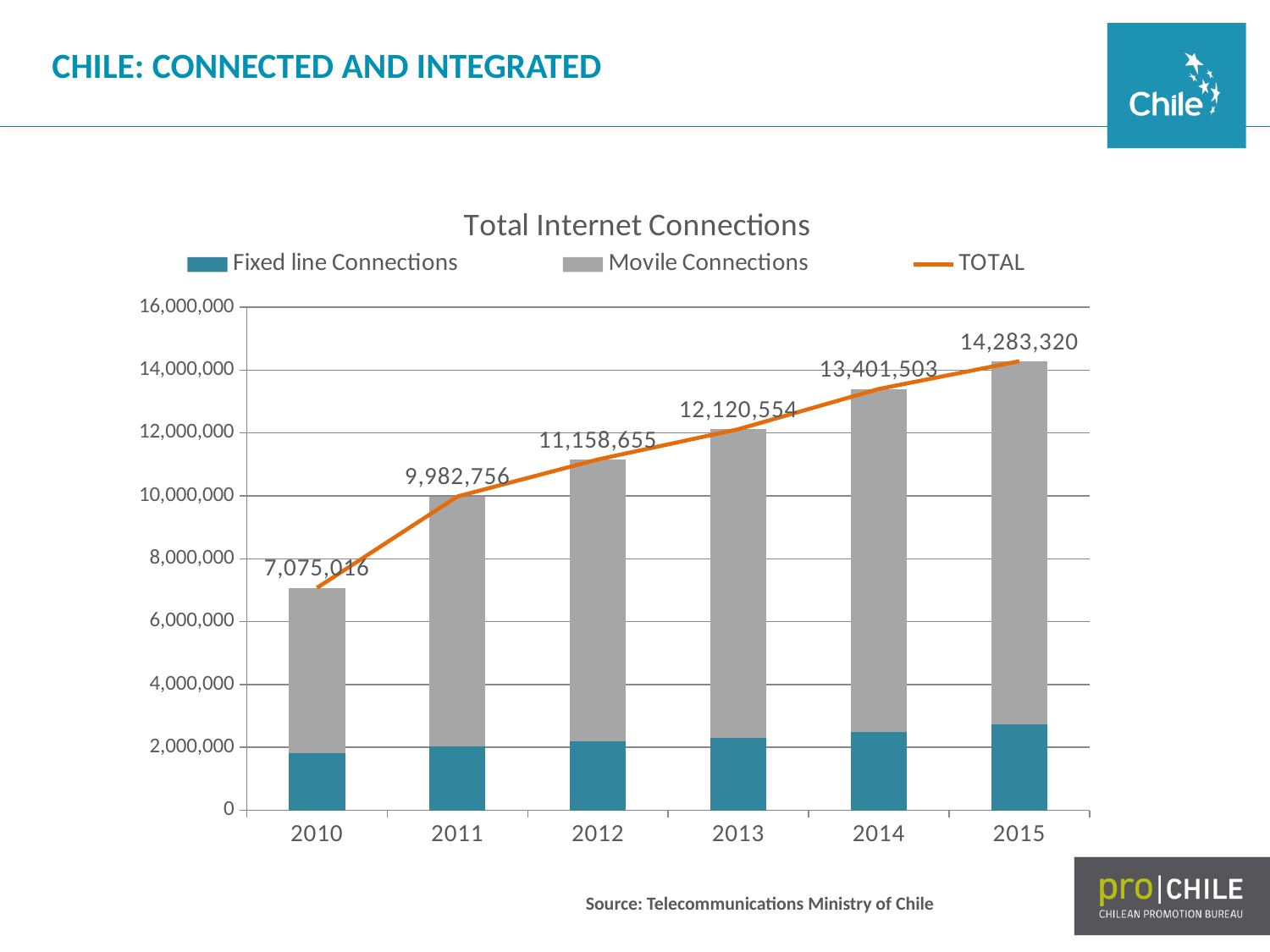
What is the difference between the TOTAL values for 2015 and 2010? 7,208,304 Is the Fixed line Connections value for 2015 greater or less than 2,000,000? greater Is the Fixed line Connections value for 2010 greater or less than 2,000,000? less Which year has the lowest TOTAL value? 2010 How many series does the legend list? 3 What is the difference between the TOTAL values for 2011 and 2010? 2,907,740 How many years are shown on the x axis? 6 Which year has the highest TOTAL value? 2015 Is the TOTAL value for 2012 larger than the TOTAL value for 2011? Yes What is the TOTAL value for 2015? 14,283,320 What is the TOTAL value for 2010? 7,075,016 What is the TOTAL value for 2013? 12,120,554